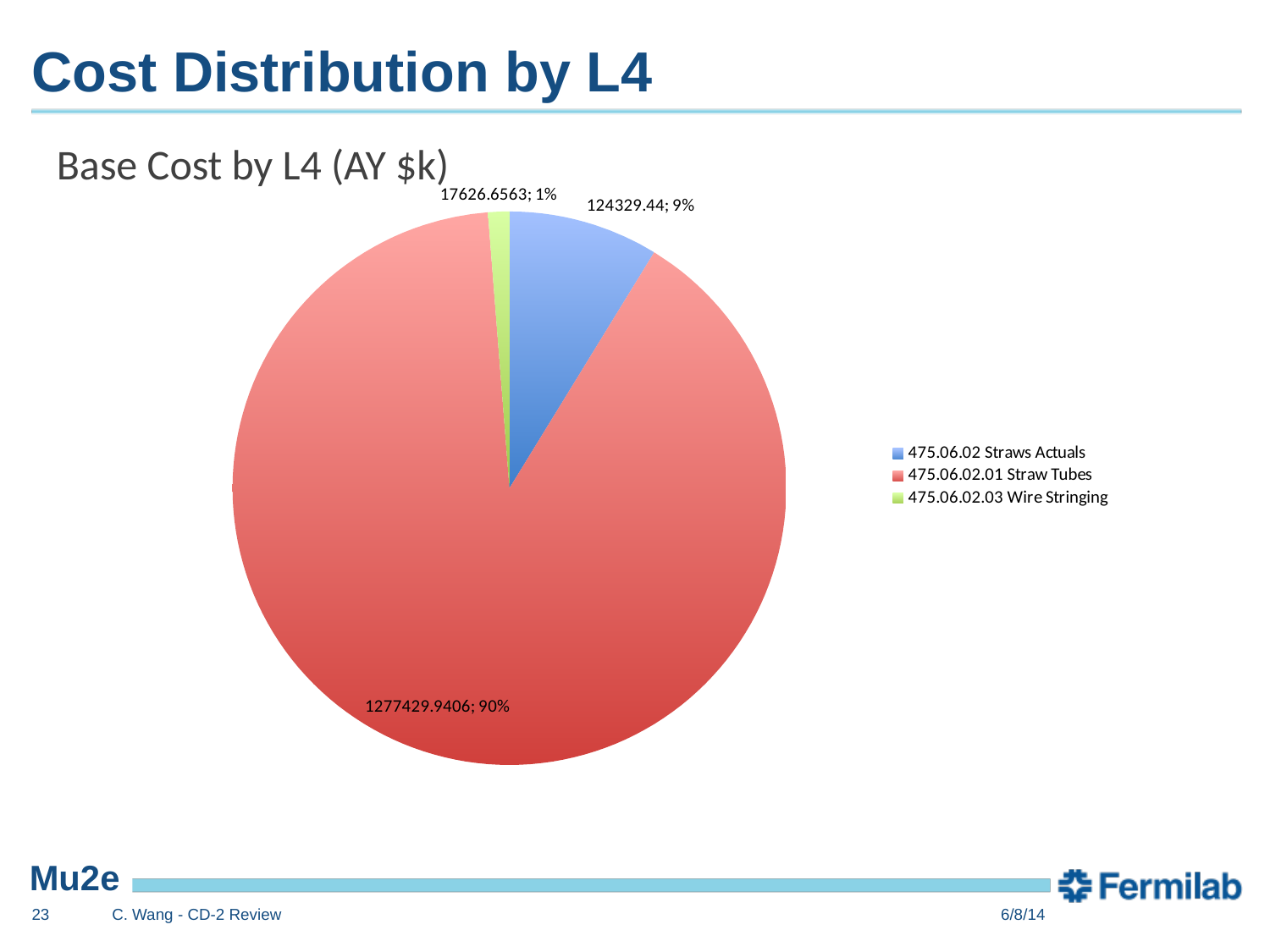
What is the value shown for 475.06.02 Straws Actuals? 124329.44 What share of the pie does 475.06.02 Straws Actuals represent? 9% What share of the pie does 475.06.02.01 Straw Tubes represent? 90% What kind of chart is shown on the slide? pie chart What is the title of the chart? Base Cost by L4 (AY $k) Which is larger, the value for 475.06.02 Straws Actuals or for 475.06.02.03 Wire Stringing? 475.06.02 Straws Actuals What is the value shown for 475.06.02.03 Wire Stringing? 17626.6563 How many entries does the legend list? 3 Which category has the largest slice of the pie? 475.06.02.01 Straw Tubes How many slices does the pie chart have? 3 What is the value shown for 475.06.02.01 Straw Tubes? 1277429.9406 Which category has the smallest slice of the pie? 475.06.02.03 Wire Stringing